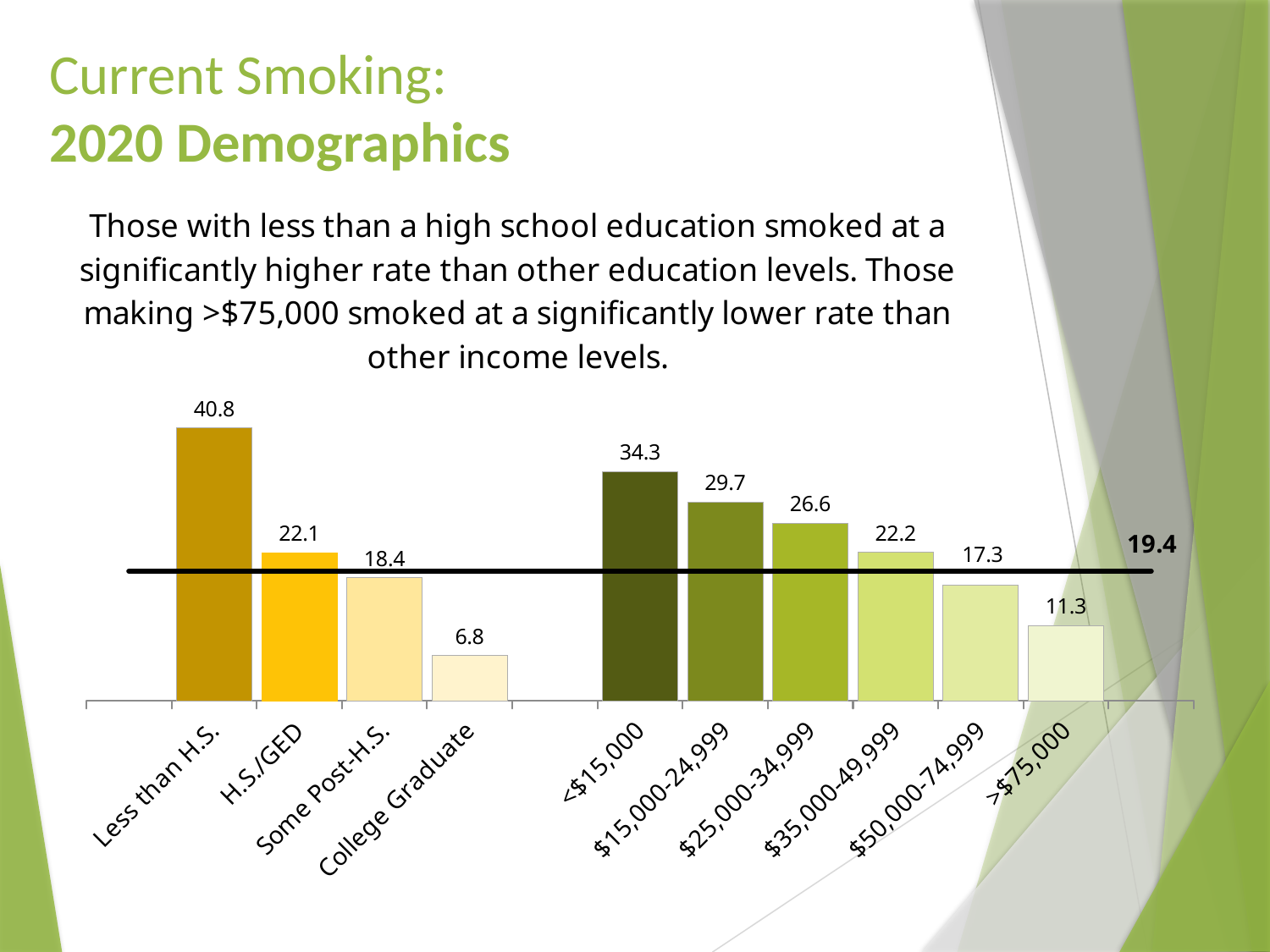
What is the difference between the values for <$15,000 and >$75,000? 23.0 What is the value for $25,000-34,999? 26.6 How many categories are plotted on the chart? 10 What is the value for Less than H.S.? 40.8 What is the difference between the values for Less than H.S. and College Graduate? 34.0 Which category has the highest value on the chart? Less than H.S. Which is larger, the value for H.S./GED or the value for $35,000-49,999? $35,000-49,999 What value is marked by the horizontal reference line across the chart? 19.4 What kind of chart is shown on the slide? Bar chart Do the values rise or fall across the income categories from <$15,000 to >$75,000? Fall What is the value for the >$75,000 income group? 11.3 Which category has the lowest value on the chart? College Graduate